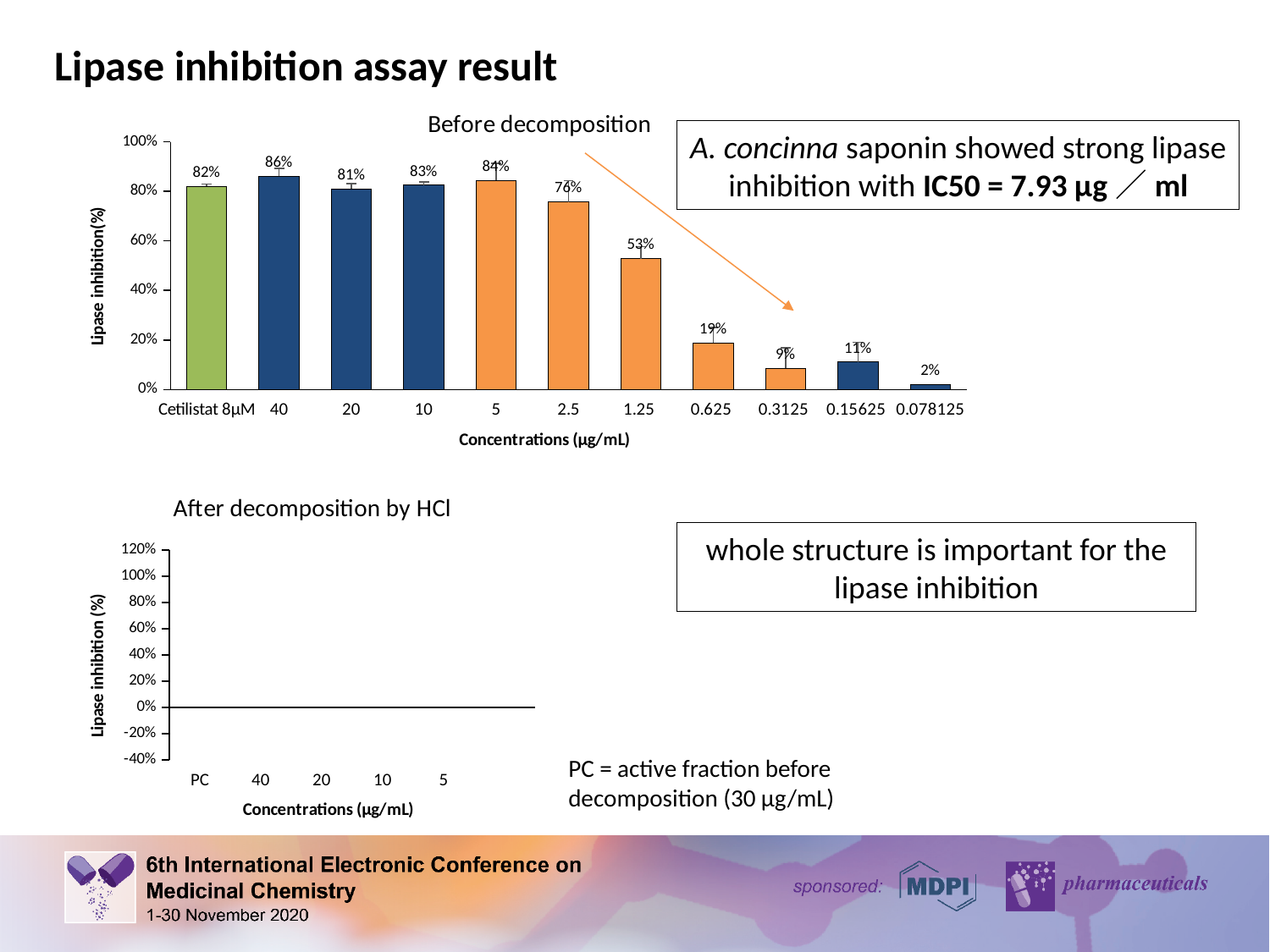
How many categories are shown on the x axis of the 'Before decomposition' chart? 11 In the 'Before decomposition' chart, what is the difference in lipase inhibition between 40 µg/mL and 1.25 µg/mL? 33% In the 'Before decomposition' chart, do the lipase inhibition values generally rise or fall as the concentration decreases from 40 to 0.078125 µg/mL? Fall In the 'Before decomposition' chart, what is the lipase inhibition at 0.078125 µg/mL? 2% In the 'Before decomposition' chart, what is the lipase inhibition at a concentration of 40 µg/mL? 86% In the 'Before decomposition' chart, which has higher lipase inhibition: 10 µg/mL or 0.625 µg/mL? 10 µg/mL In the 'Before decomposition' chart, which category has the lowest lipase inhibition? 0.078125 In the 'Before decomposition' chart, is the lipase inhibition at 2.5 µg/mL greater or less than 60%? greater What kind of chart is the 'Before decomposition' chart? Bar chart In the 'Before decomposition' chart, what is the lipase inhibition at 1.25 µg/mL? 53% In the 'Before decomposition' chart, which concentration has the highest lipase inhibition? 40 In the 'Before decomposition' chart, what is the lipase inhibition value for Cetilistat 8µM? 82%